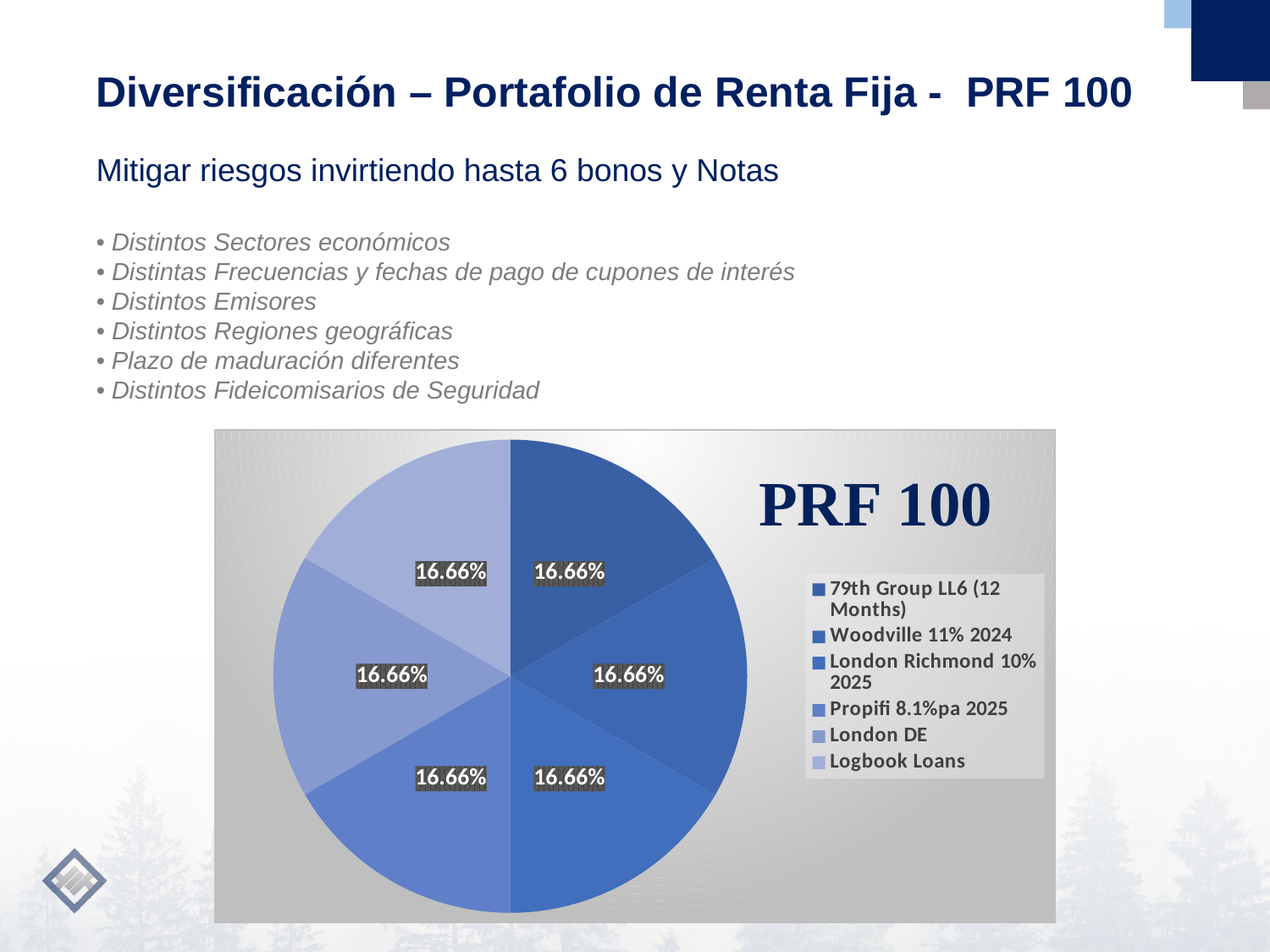
What is the value shown for Propifi 8.1%pa 2025? 16.66% What share of the pie does Woodville 11% 2024 represent? 16.66% What is the value shown for Logbook Loans? 16.66% What kind of chart is shown on the slide? pie chart How many entries does the chart legend list? 6 Which legend entry is listed first in the chart legend? 79th Group LL6 (12 Months) What is the value shown for London DE? 16.66% How many slices does the pie chart have? 6 What is the value shown for 79th Group LL6 (12 Months)? 16.66% What is the difference between the values for London Richmond 10% 2025 and Logbook Loans? 0% What is the title of the chart? PRF 100